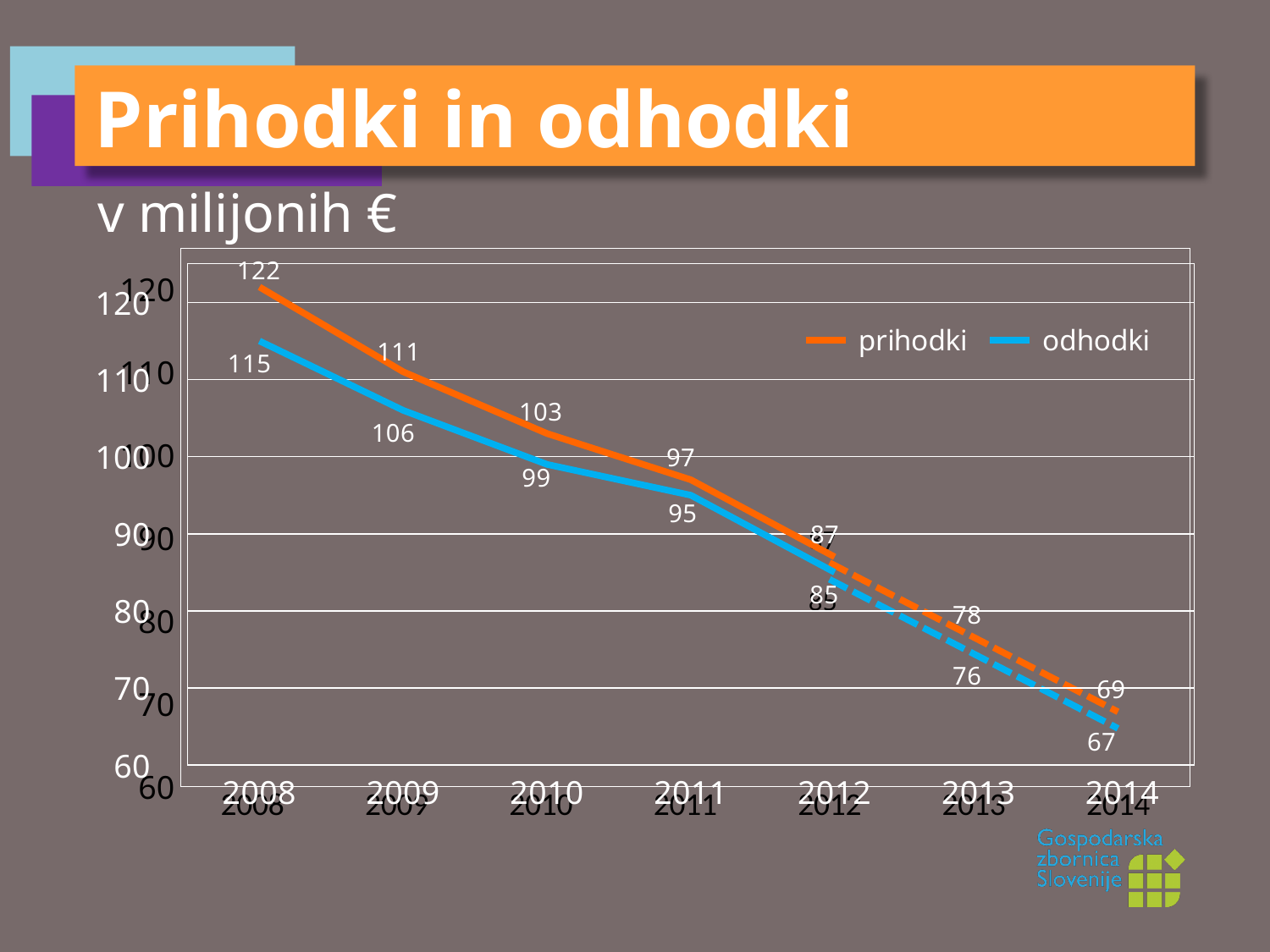
What is the value for prihodki in 2013? 78 What is the value for odhodki in 2014? 67 What is the value for prihodki in 2008? 122 What is the value for odhodki in 2010? 99 Which is larger in 2011, prihodki or odhodki? prihodki What kind of chart is shown on the slide? line chart What is the difference between prihodki and odhodki in 2008? 7 In which year is odhodki lowest? 2014 What is the difference between prihodki in 2008 and prihodki in 2014? 53 How many years are shown on the x axis? 7 In which year is prihodki highest? 2008 How many series does the legend list? 2